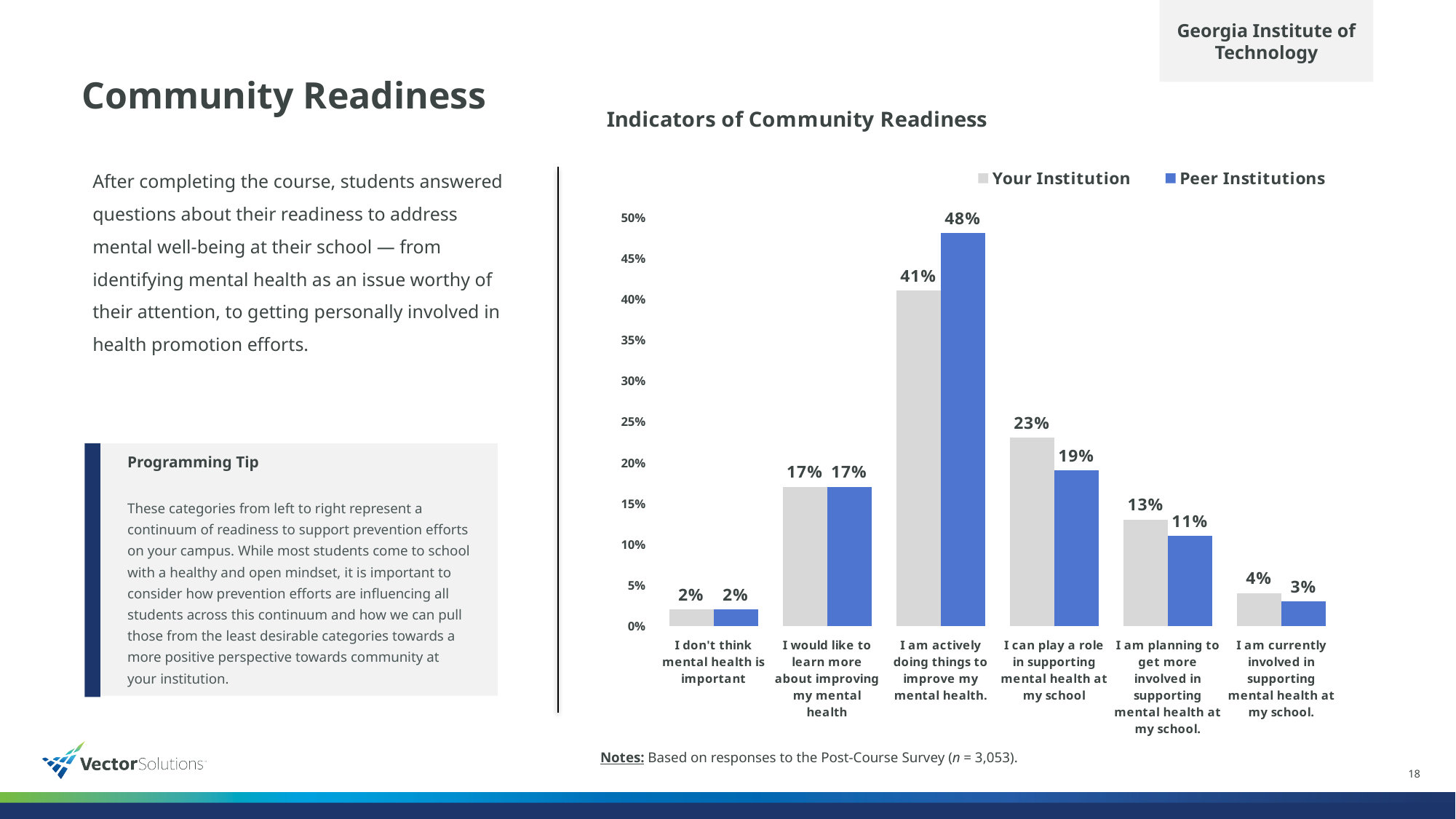
What is the difference between Peer Institutions and Your Institution for "I am actively doing things to improve my mental health."? 7% For "I can play a role in supporting mental health at my school", which is larger: Your Institution or Peer Institutions? Your Institution What is the value for Peer Institutions for "I am currently involved in supporting mental health at my school."? 3% What is the value for Your Institution for "I am planning to get more involved in supporting mental health at my school."? 13% Which category has the highest value for Peer Institutions? I am actively doing things to improve my mental health. What is the value for Peer Institutions for "I can play a role in supporting mental health at my school"? 19% What kind of chart is shown? Bar chart Which category has the lowest value for Your Institution? I don't think mental health is important What is the title of the chart? Indicators of Community Readiness How many series does the legend list? 2 How many categories are shown on the x axis? 6 What is the value for Your Institution for "I am actively doing things to improve my mental health."? 41%